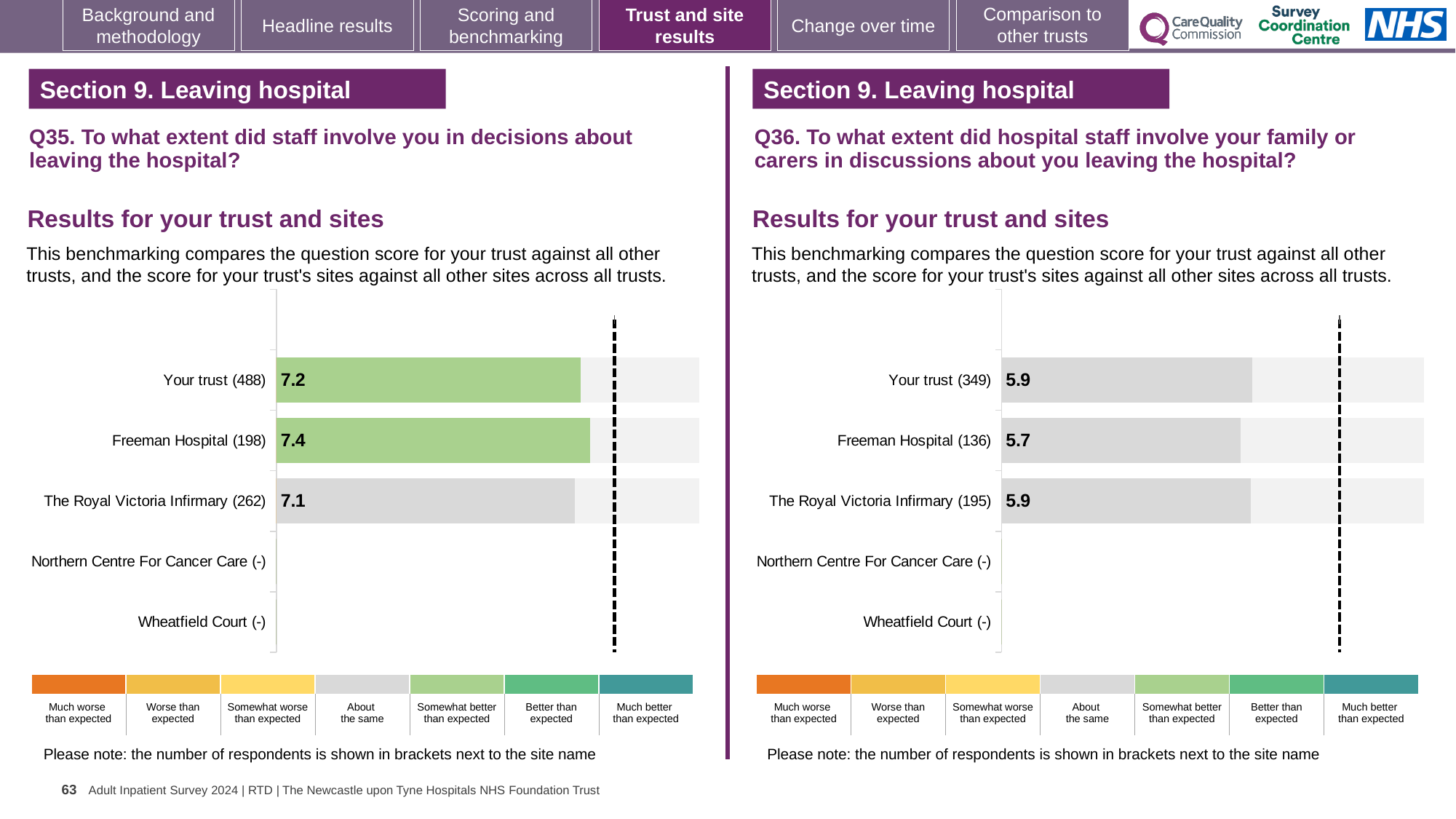
In the Q35 chart on the left, what is the score for Freeman Hospital? 7.4 What kind of chart is used for the Q35 results on the left? Bar chart In the Q35 chart on the left, which site or trust row has the lowest score? The Royal Victoria Infirmary In the Q36 chart on the right, what is the difference between the scores for Your trust and Freeman Hospital? 0.2 In the Q36 chart on the right, what is the score for The Royal Victoria Infirmary? 5.9 In the Q35 chart on the left, what is the score for Your trust? 7.2 In the Q35 chart on the left, which site or trust row has the highest score? Freeman Hospital In the Q36 chart on the right, which site or trust row has the lowest score? Freeman Hospital In the Q35 chart on the left, which has the larger score, Your trust or The Royal Victoria Infirmary? Your trust How many site or trust rows are listed in the Q36 chart on the right? 5 In the Q35 chart on the left, what is the difference between the scores for Freeman Hospital and The Royal Victoria Infirmary? 0.3 In the Q36 chart on the right, what is the score for Freeman Hospital? 5.7